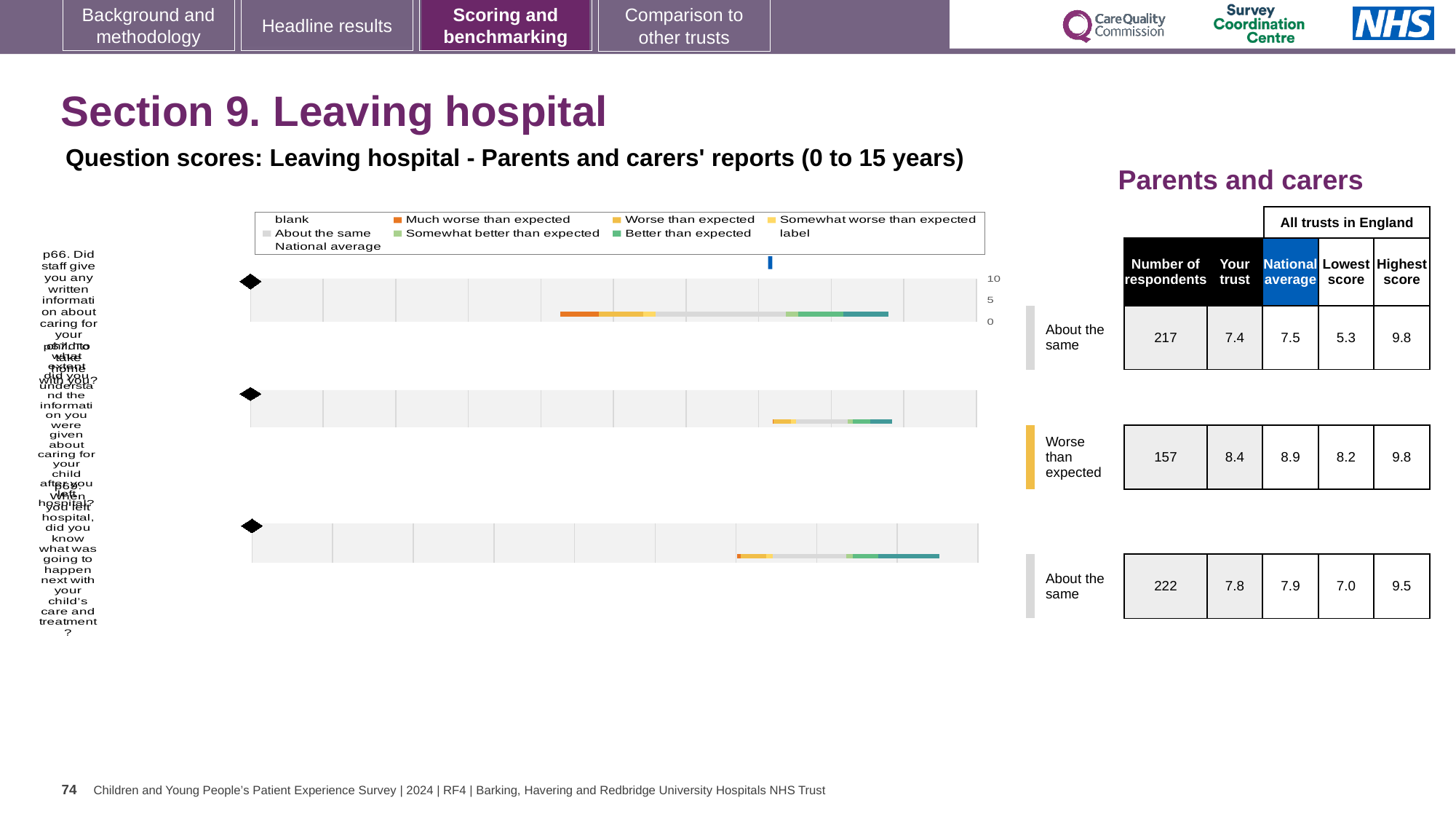
What is the 'Your trust' score for the first (top) question, p66, in the Leaving hospital chart? 7.4 For the third (bottom) question in the Leaving hospital chart, which is larger: the 'Your trust' score or the national average? National average Which question in the Leaving hospital chart is rated 'Worse than expected'? the second (middle) question Which question in the Leaving hospital chart has the lowest 'Lowest score' across all trusts in England? the first (top) question, p66, 5.3 How many questions (bars) are plotted in the Leaving hospital chart? 3 What is the national average for the third (bottom) question in the Leaving hospital chart? 7.9 For the second (middle) question in the Leaving hospital chart, what is the difference between the national average and the 'Your trust' score? 0.5 How many entries does the legend of the Leaving hospital chart list? 9 What is the highest score across all trusts in England for the third (bottom) question in the Leaving hospital chart? 9.5 How many respondents are shown for the second (middle) question in the Leaving hospital chart? 157 Which question in the Leaving hospital chart has the highest 'Your trust' score? the second (middle) question, 8.4 What kind of chart is used to show the question scores for Leaving hospital? bar chart